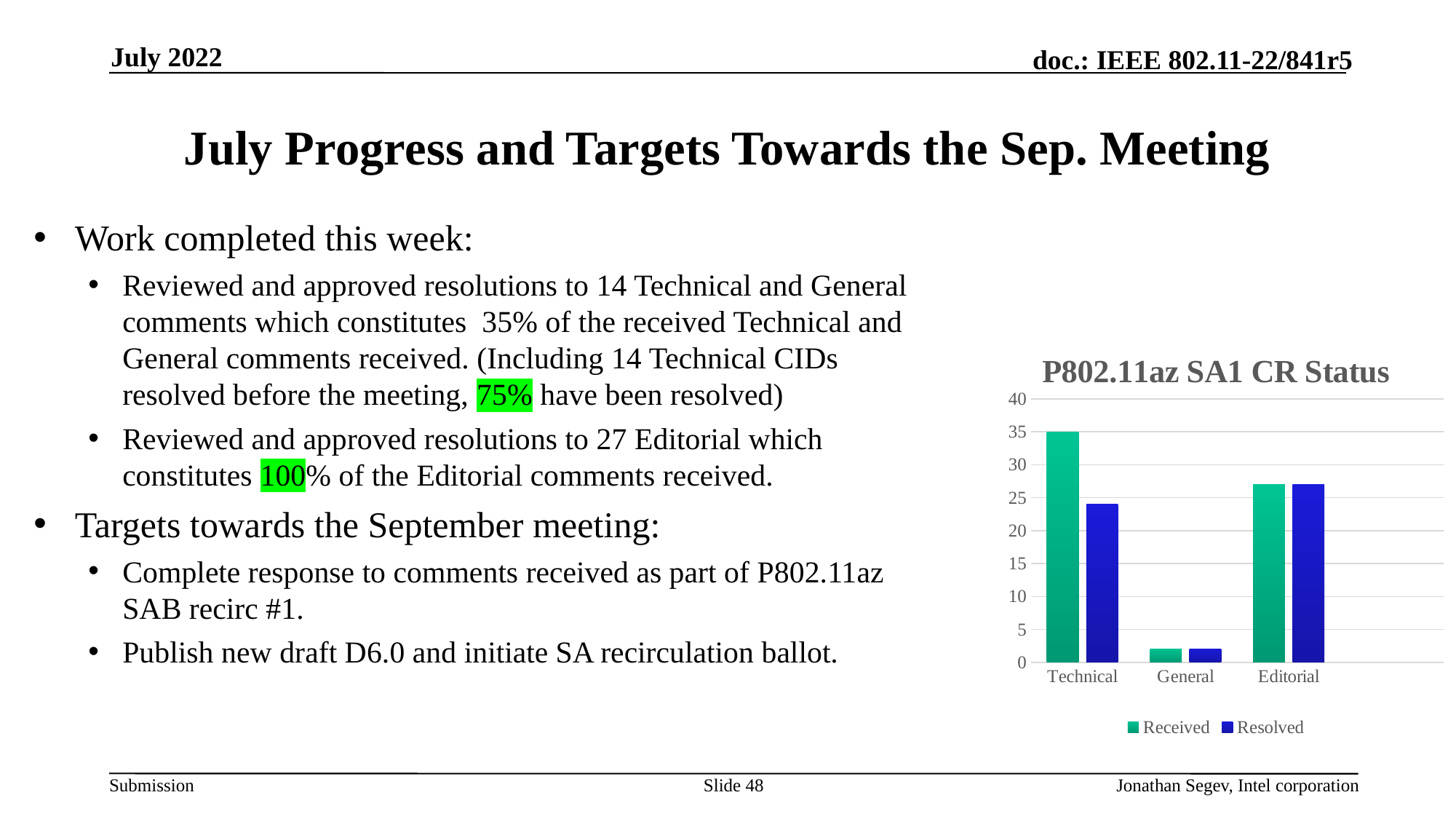
Which category has the lowest Received value? General How many series does the chart legend list? 2 How many categories are shown on the x axis of the chart? 3 For Technical, which is larger: Received or Resolved? Received What is the title of the chart? P802.11az SA1 CR Status Which category has the highest Received value? Technical Which category has the lowest Resolved value? General Is the Received value for General greater or less than 5? less Is the Resolved value for Technical greater or less than 20? greater Is the Received value for Technical greater or less than 30? greater What kind of chart is shown on the slide? bar chart